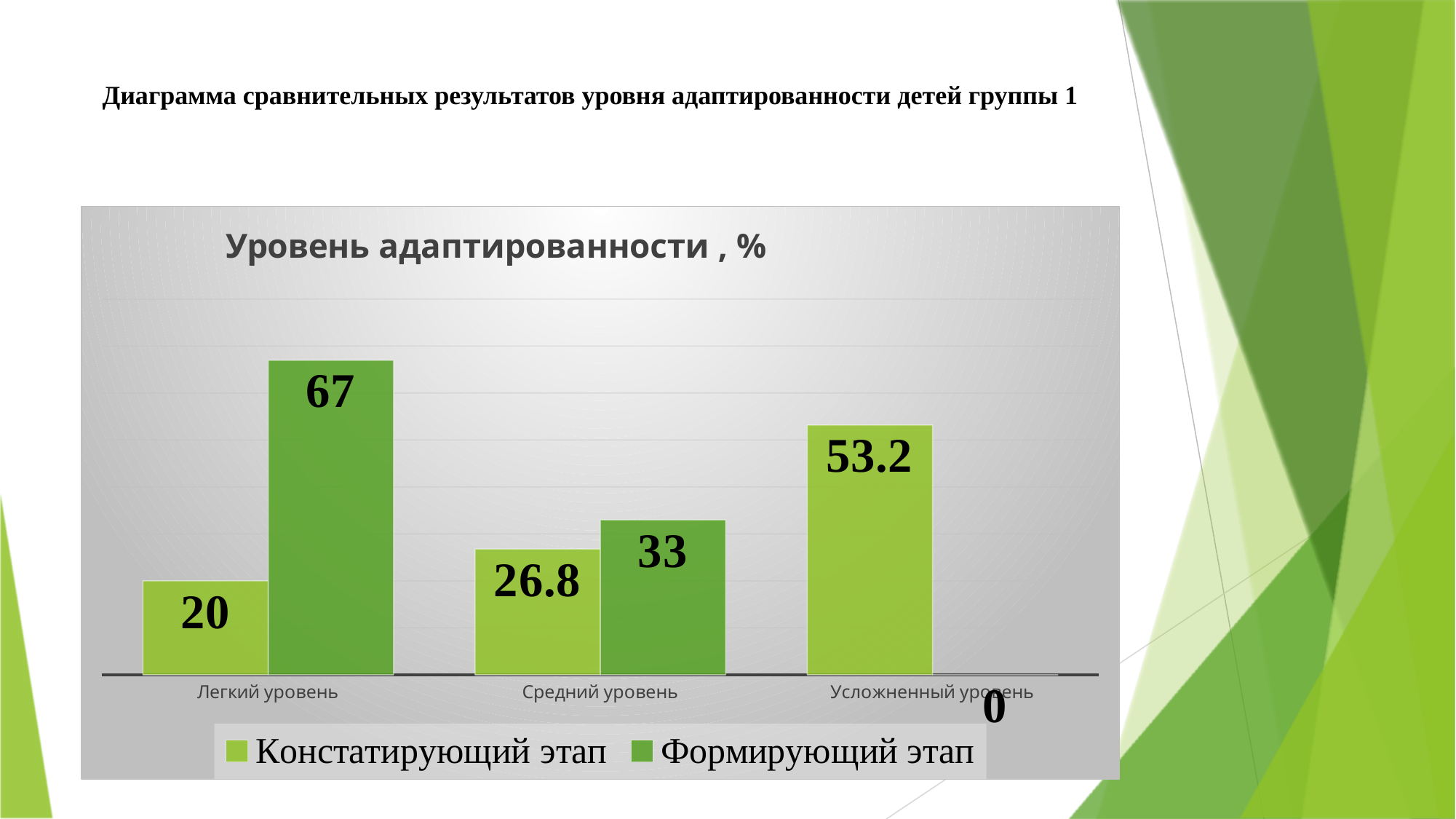
What kind of chart is this? Bar chart Which category has the highest value for Констатирующий этап? Усложненный уровень What is the value for Формирующий этап at Усложненный уровень? 0 Which is larger at Средний уровень: Констатирующий этап or Формирующий этап? Формирующий этап What is the difference between Формирующий этап and Констатирующий этап at Легкий уровень? 47 How many series does the legend list? 2 What is the value for Констатирующий этап at Легкий уровень? 20 What is the title of the chart? Уровень адаптированности , % Which category has the lowest value for Формирующий этап? Усложненный уровень How many categories are shown on the x axis? 3 What is the value for Констатирующий этап at Средний уровень? 26.8 What is the value for Формирующий этап at Легкий уровень? 67